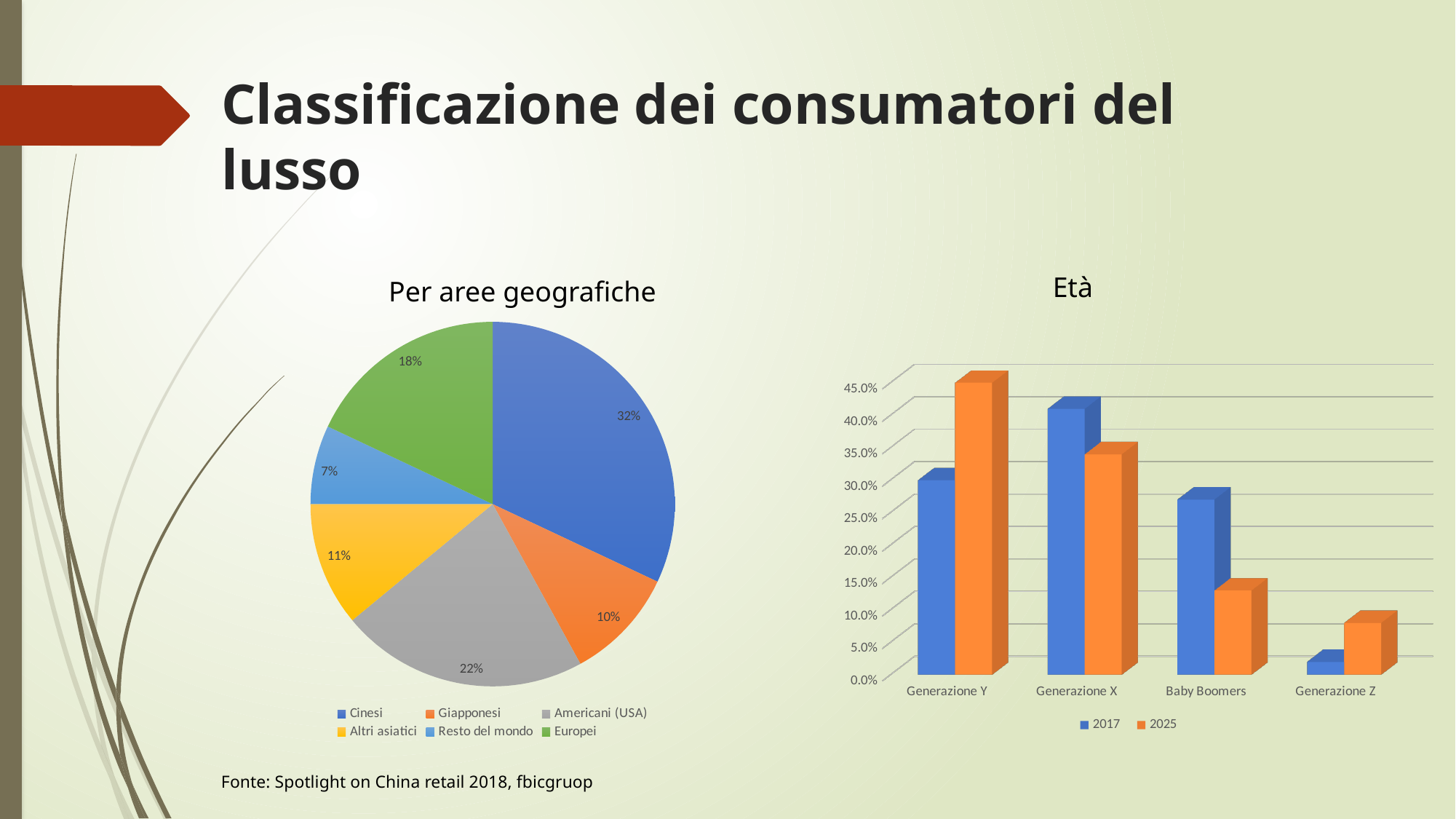
In the 'Per aree geografiche' pie chart, what share is shown for Cinesi? 32% In the 'Per aree geografiche' pie chart, how many categories does the legend list? 6 In the 'Per aree geografiche' pie chart, which category has the smallest slice? Resto del mondo In the 'Età' chart, which is larger for Baby Boomers, the 2017 value or the 2025 value? 2017 In the 'Età' chart, is the 2025 value for Generazione Y greater or less than 40.0%? greater In the 'Per aree geografiche' pie chart, what share is shown for Resto del mondo? 7% In the 'Età' chart, is the 2017 value for Generazione Z greater or less than 5.0%? less In the 'Per aree geografiche' pie chart, which category has the largest slice? Cinesi In the 'Per aree geografiche' pie chart, what share is shown for Americani (USA)? 22% What kind of chart is the 'Età' chart on the right? Bar chart In the 'Per aree geografiche' pie chart, what is the difference between the Europei share and the Giapponesi share? 8% In the 'Età' chart, how many series does the legend list? 2